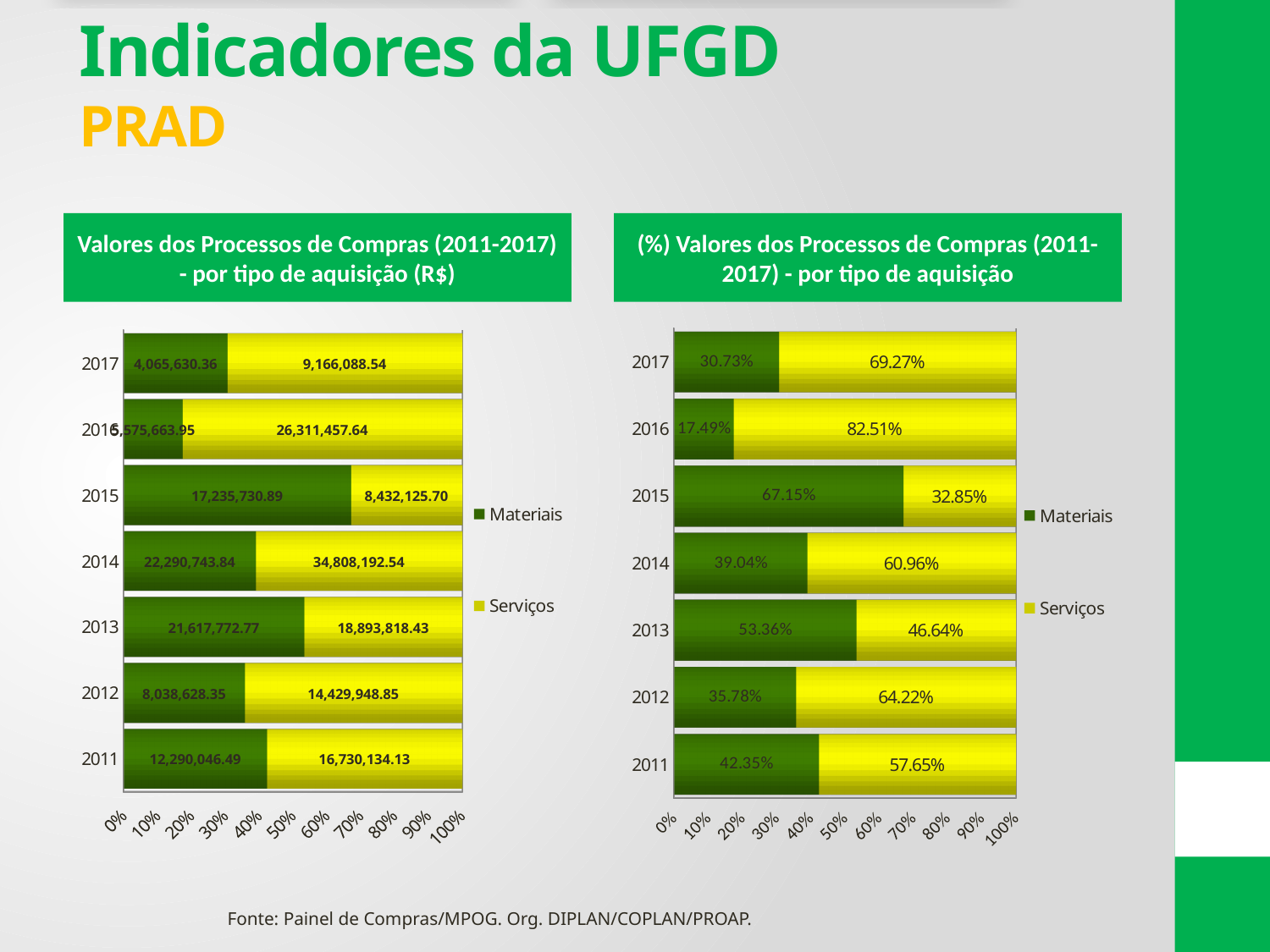
In the right chart ((%) Valores dos Processos de Compras), is the Materiais share for 2012 greater or less than 40%? less In the right chart ((%) Valores dos Processos de Compras), which year has the lowest Materiais share? 2016 In the left chart (Valores dos Processos de Compras, R$), which is larger in 2013, Materiais or Serviços? Materiais In the right chart ((%) Valores dos Processos de Compras), what is the Materiais share for 2013? 53.36% How many years are shown in the left chart (Valores dos Processos de Compras, R$)? 7 In the left chart (Valores dos Processos de Compras, R$), what is the value for Materiais in 2015? 17,235,730.89 In the right chart ((%) Valores dos Processos de Compras), which year has the highest Materiais share? 2015 In the left chart (Valores dos Processos de Compras, R$), what is the difference between Serviços and Materiais in 2017? 5,100,458.18 In the left chart (Valores dos Processos de Compras, R$), what is the value for Serviços in 2014? 34,808,192.54 In the right chart ((%) Valores dos Processos de Compras), what is the Serviços share for 2016? 82.51% How many series does the legend of the right chart ((%) Valores dos Processos de Compras) list? 2 What kind of chart is the right chart ((%) Valores dos Processos de Compras)? Stacked bar chart